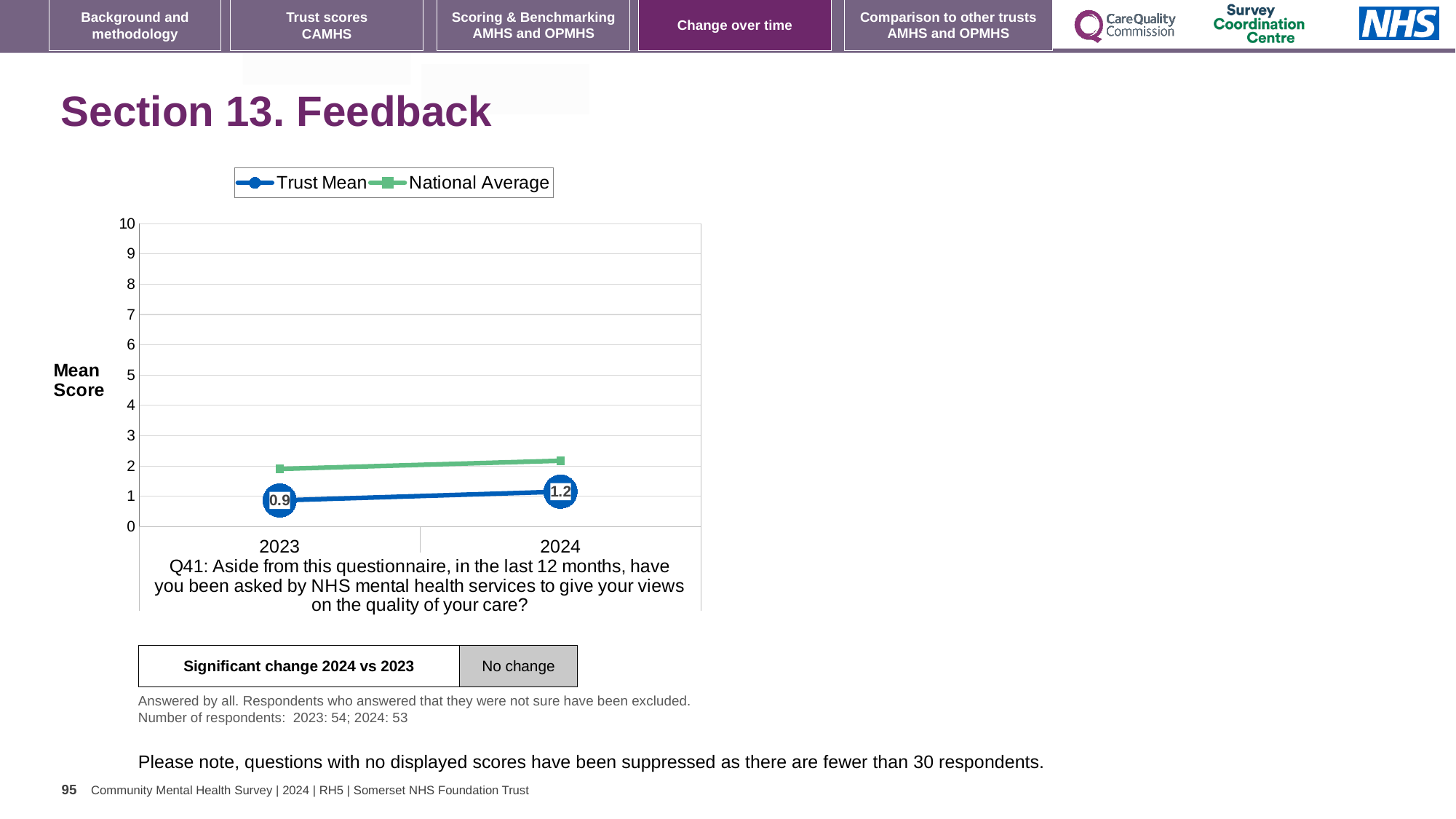
Does the Trust Mean line rise or fall from 2023 to 2024? rises What is the difference between the Trust Mean values for 2024 and 2023? 0.3 What is the label on the y axis of the chart? Mean Score Is the National Average value for 2023 greater or less than 3? less In 2024, which is larger, the National Average or the Trust Mean? National Average How many years are plotted on the x axis? 2 What kind of chart is shown on the slide? line chart Which year has the highest Trust Mean value? 2024 What is the Trust Mean value for 2024? 1.2 What is the Trust Mean value for 2023? 0.9 How many series does the legend list? 2 Which year has the higher Trust Mean value, 2023 or 2024? 2024